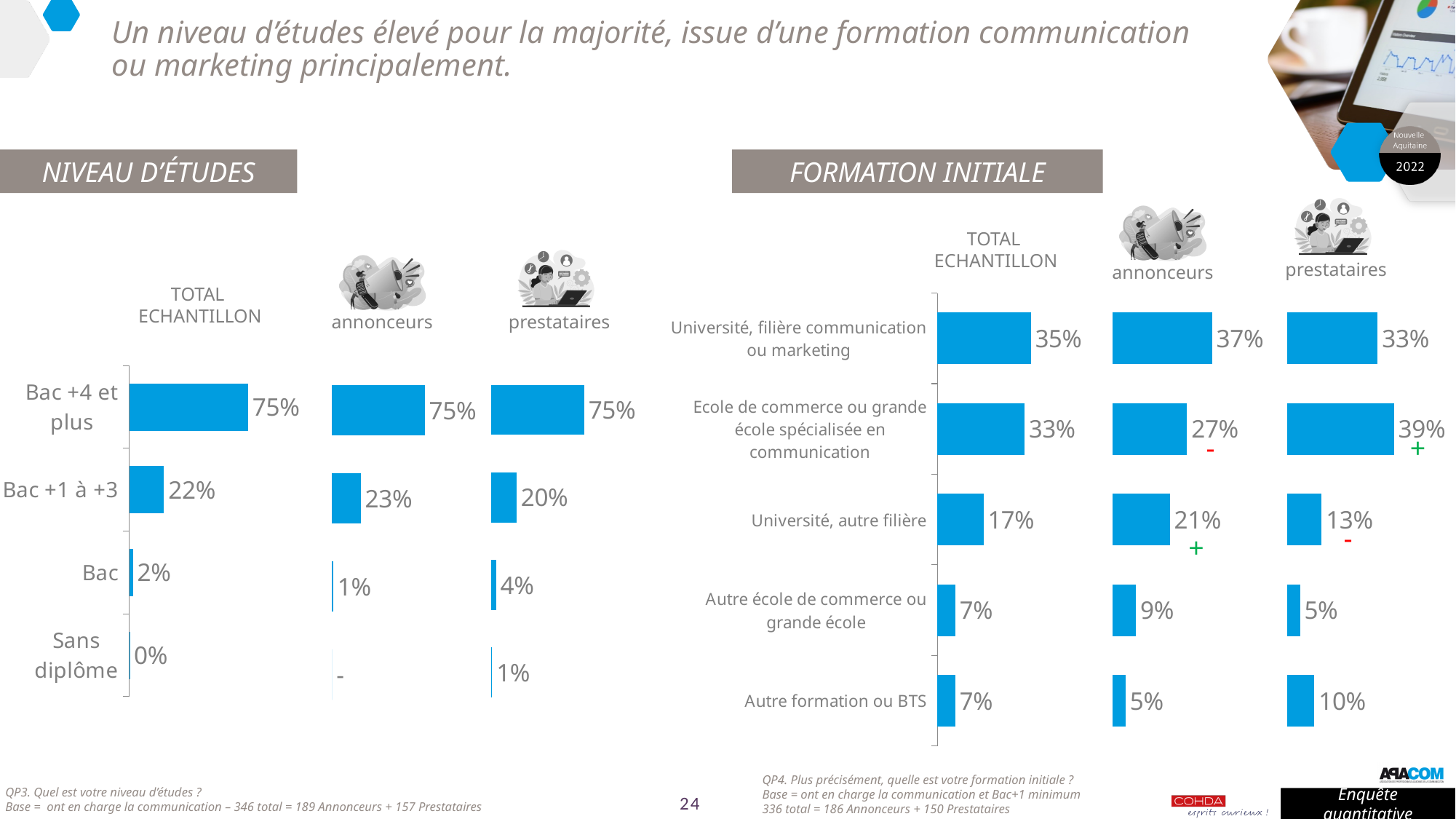
In the FORMATION INITIALE chart, which is larger for 'Université, filière communication ou marketing': the annonceurs value or the prestataires value? annonceurs In the FORMATION INITIALE chart, what is the annonceurs value for 'Ecole de commerce ou grande école spécialisée en communication'? 27% In the FORMATION INITIALE chart, what is the difference between the prestataires and annonceurs values for 'Université, autre filière'? 8% In the NIVEAU D'ÉTUDES chart, what is the TOTAL ECHANTILLON value for 'Bac +4 et plus'? 75% In the FORMATION INITIALE chart, how many formation categories are listed? 5 In the NIVEAU D'ÉTUDES chart, what is the prestataires value for 'Bac +1 à +3'? 20% In the NIVEAU D'ÉTUDES chart, which category has the highest TOTAL ECHANTILLON value? Bac +4 et plus In the FORMATION INITIALE chart, which category has the highest prestataires value? Ecole de commerce ou grande école spécialisée en communication What type of chart is used in the NIVEAU D'ÉTUDES section? Bar chart In the NIVEAU D'ÉTUDES chart, what is the annonceurs value for 'Bac'? 1% In the NIVEAU D'ÉTUDES chart, how many education-level categories are listed? 4 In the FORMATION INITIALE chart, what is the prestataires value for 'Autre formation ou BTS'? 10%